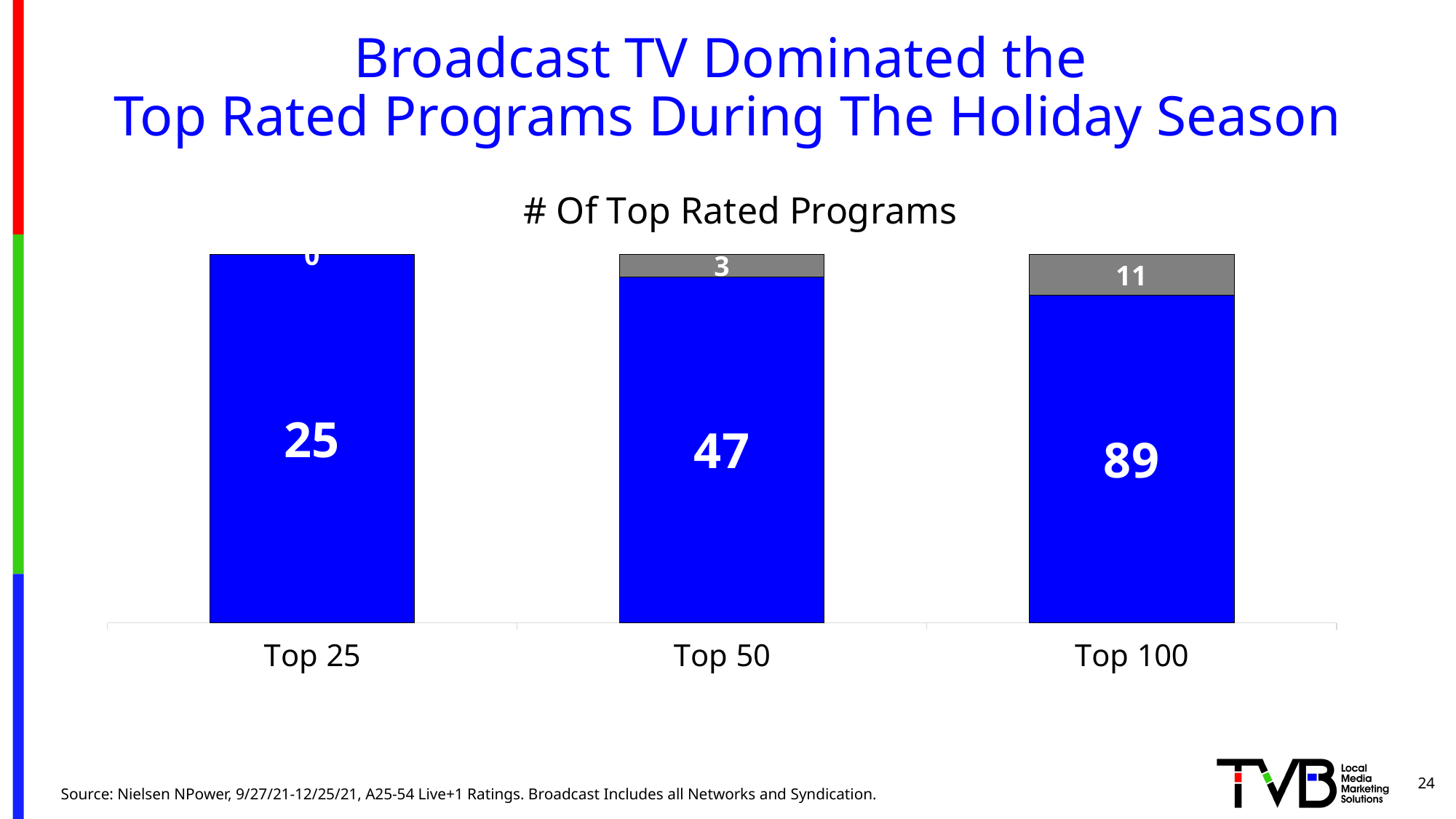
What kind of chart is shown on the slide? stacked bar chart Which category has the largest blue segment? Top 100 What is the difference between the gray segment values for Top 100 and Top 50? 8 What is the value of the gray segment for Top 100? 11 What is the value of the blue segment for Top 100? 89 What is the value of the blue segment for Top 50? 47 Which category has the smallest blue segment? Top 25 What is the total of the stacked bar for Top 100? 100 What is the difference between the blue segment values for Top 100 and Top 50? 42 In the Top 50 bar, which segment is larger, the blue or the gray? blue What is the value of the gray segment for Top 50? 3 How many categories are shown on the x axis? 3